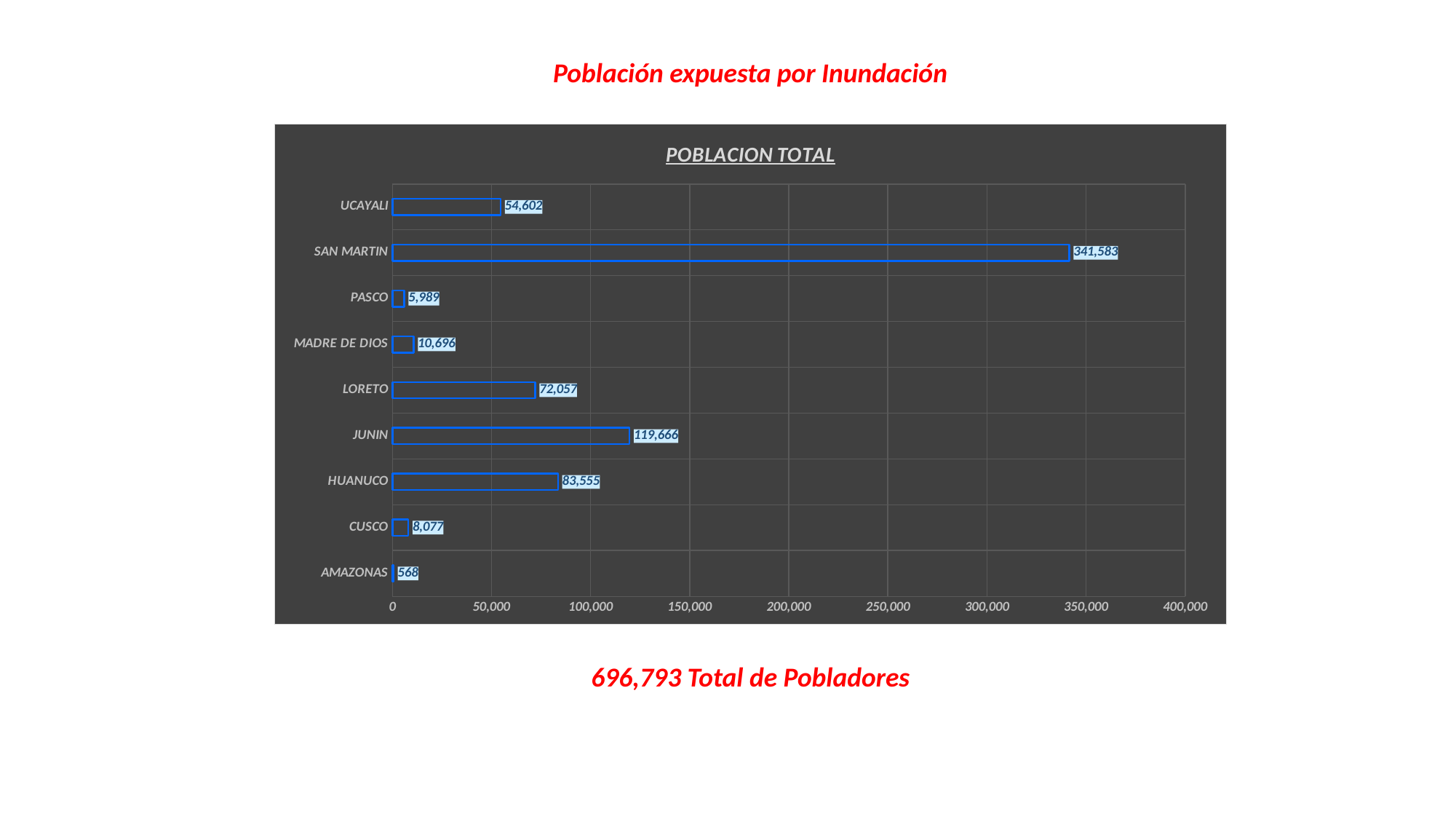
What is the title of the chart? POBLACION TOTAL Which is larger, the value for HUANUCO or the value for UCAYALI? HUANUCO How many categories are shown in the chart? 9 What is the value for MADRE DE DIOS? 10,696 What is the difference between the values for JUNIN and LORETO? 47,609 Which category has the highest value? SAN MARTIN What is the difference between the values for CUSCO and PASCO? 2,088 What is the value for JUNIN? 119,666 Which category has the lowest value? AMAZONAS Is the value for LORETO greater or less than 50,000? greater What kind of chart is shown? Bar chart What is the value for SAN MARTIN? 341,583